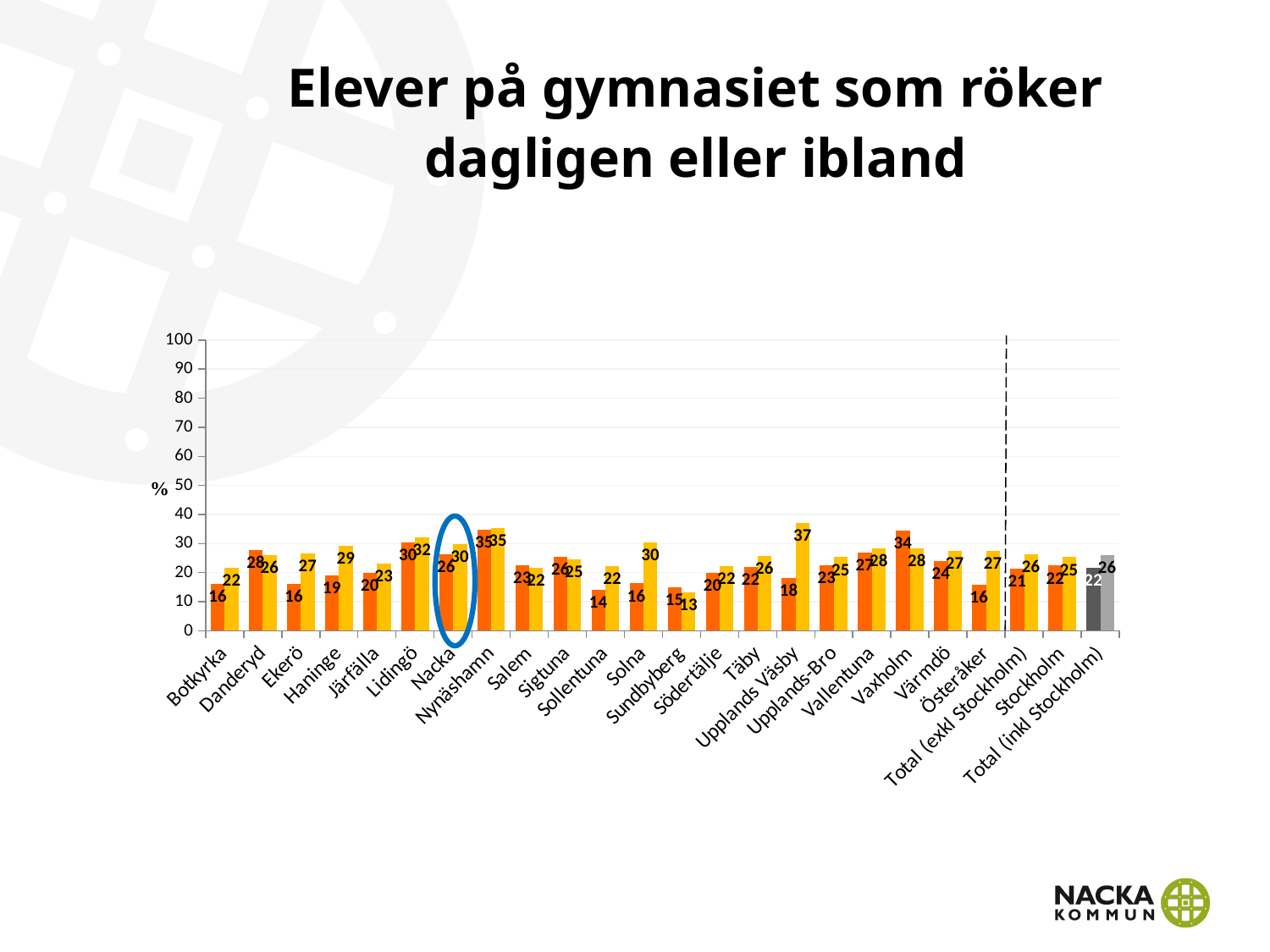
Which municipality has the highest yellow bar? Upplands Väsby What is the title of the chart? Elever på gymnasiet som röker dagligen eller ibland Which municipality has the lowest yellow bar? Sundbyberg What is the value of the orange bar for Upplands Väsby? 18 Which is larger for Vaxholm, the orange bar or the yellow bar? the orange bar What is the difference between the yellow bar and the orange bar for Solna? 14 Is the value of the yellow bar for Upplands Väsby greater or less than 30? greater Which municipality has the highest orange bar? Nynäshamn What kind of chart is shown on the slide? bar chart How many categories are shown on the x axis? 24 What is the value of the yellow bar for Nacka? 30